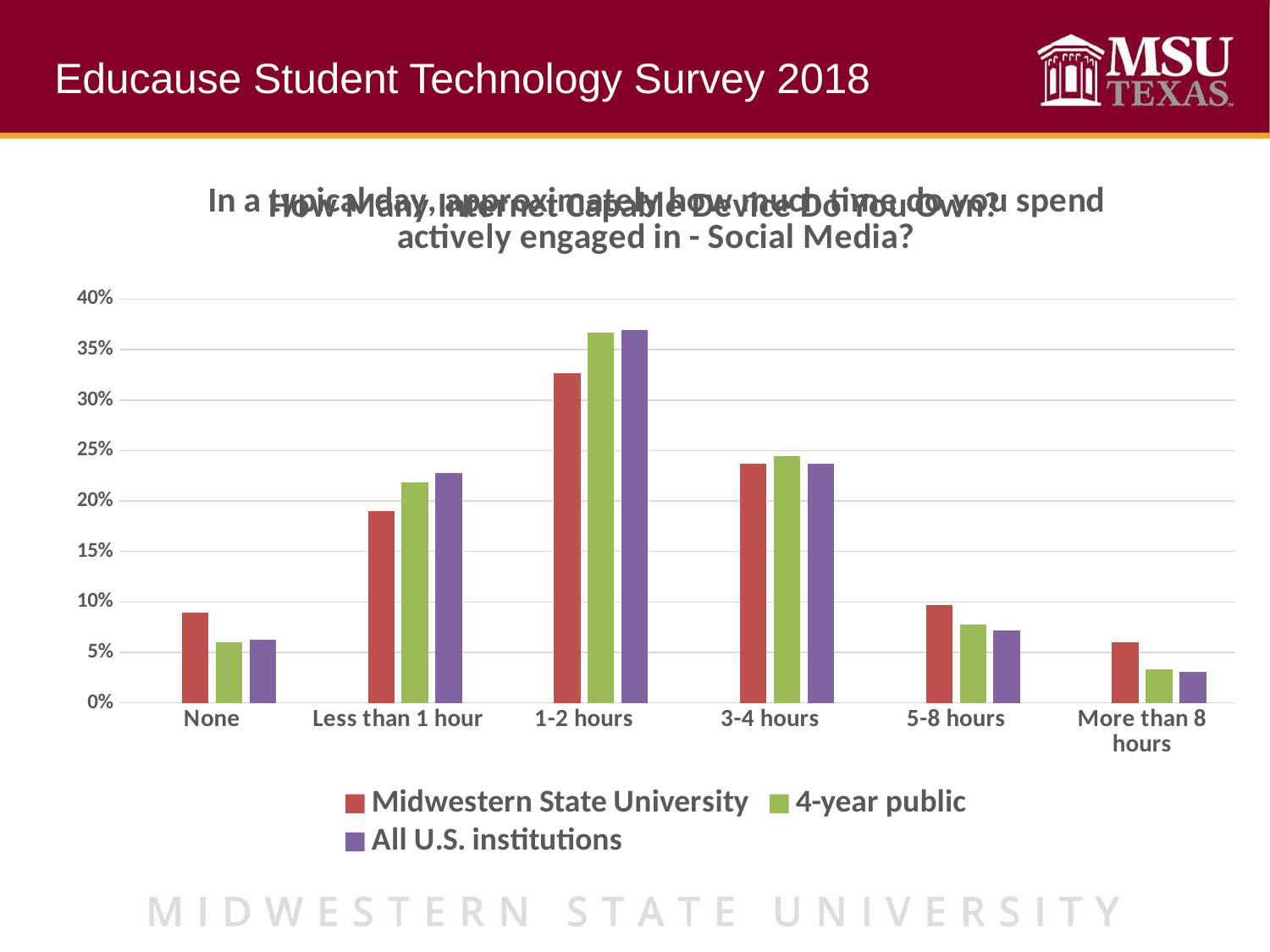
How many time categories are shown along the x axis of the chart? 6 Is the Midwestern State University value for 1-2 hours greater or less than 30%? greater Is the Midwestern State University value for Less than 1 hour greater or less than 20%? less Which category has the lowest value for All U.S. institutions? More than 8 hours How many series does the chart's legend list? 3 Which category has the highest value for Midwestern State University? 1-2 hours For Less than 1 hour, which is larger: Midwestern State University or All U.S. institutions? All U.S. institutions Is the All U.S. institutions value for 1-2 hours greater or less than 35%? greater For 5-8 hours, which is larger: Midwestern State University or 4-year public? Midwestern State University What kind of chart is shown on the slide? Bar chart Which category has the lowest value for Midwestern State University? More than 8 hours